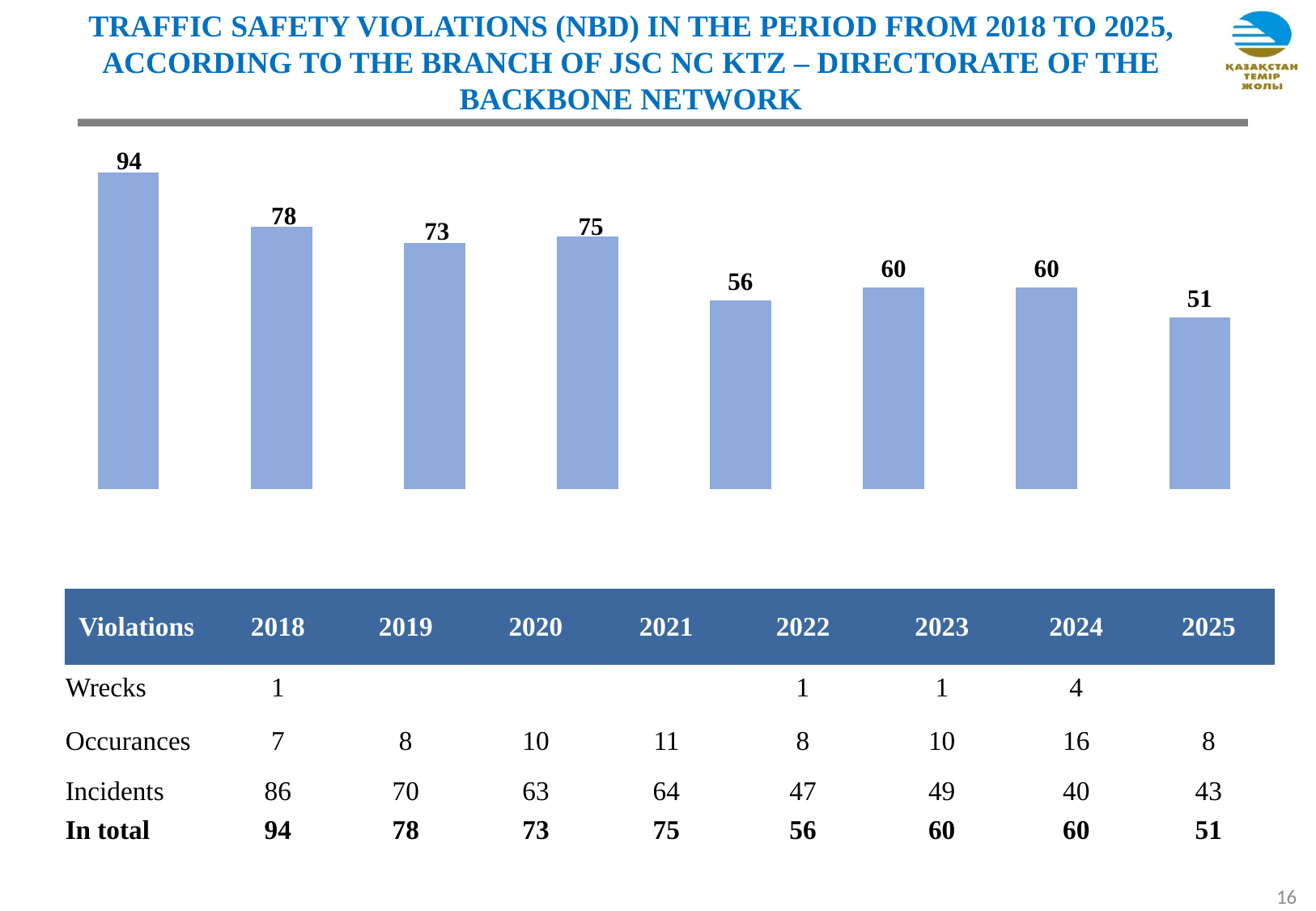
What is the value of the first (leftmost) bar in the chart? 94 What is the difference between the second bar (78) and the third bar (73)? 5 Which is larger, the third bar or the fourth bar? the fourth bar (75) What colour are the bars in the chart? light blue Which bar has the lowest value in the chart? the last bar (51) How many bars are plotted in the chart? 8 What is the value of the last (rightmost) bar in the chart? 51 What is the difference between the first bar (94) and the last bar (51)? 43 Do the bar values generally rise or fall from left to right? fall What type of chart is shown on the slide? bar chart Which bar has the highest value in the chart? the first bar (94) What is the value of the fifth bar from the left in the chart? 56